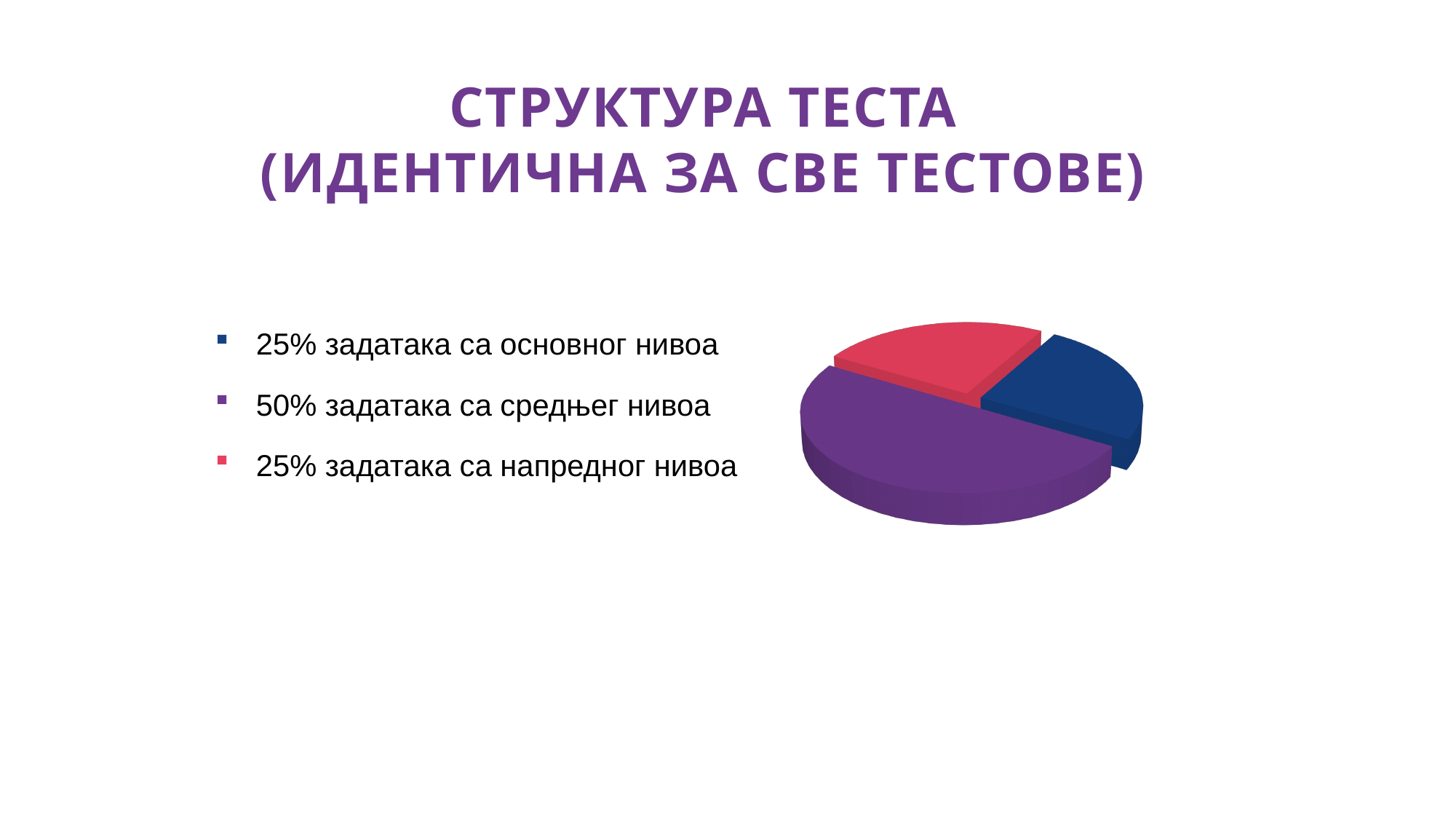
What share of the tasks are from the basic level (основног нивоа)? 25% What kind of chart is shown on the slide? Pie chart What share of the tasks are from the advanced level (напредног нивоа)? 25% Which level has the largest slice of the pie chart? Intermediate level (средњег нивоа) How many slices does the pie chart have? 3 What share of the tasks are from the intermediate level (средњег нивоа)? 50% Is the share of intermediate-level tasks greater or less than 40%? greater What is the title of the slide containing the pie chart? СТРУКТУРА ТЕСТА (ИДЕНТИЧНА ЗА СВЕ ТЕСТОВЕ) What is the difference between the share of intermediate-level tasks and basic-level tasks? 25% What is the combined share of basic-level and advanced-level tasks? 50% Which is larger: the share of intermediate-level tasks or the share of advanced-level tasks? Intermediate-level tasks What colour is the slice representing the intermediate level (средњег нивоа)? Purple